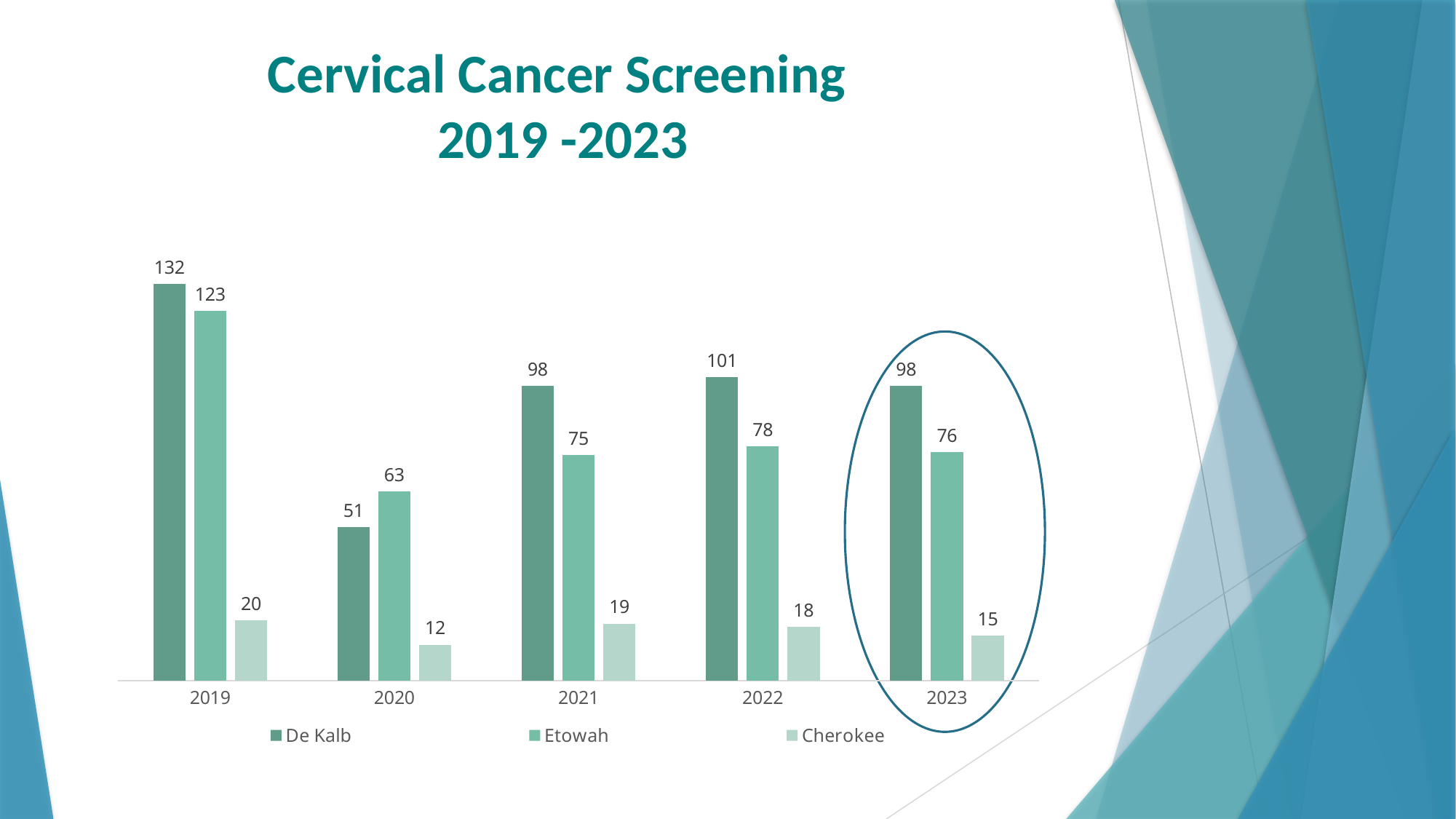
In which year is the De Kalb value lowest? 2020 How many years are shown on the x axis? 5 Which year's group of bars is circled on the chart? 2023 How many series does the legend list? 3 Which is larger in 2020, De Kalb or Etowah? Etowah What is the value for Etowah in 2020? 63 What is the difference between the De Kalb and Etowah values in 2022? 23 What kind of chart is shown on the slide? Bar chart What is the value for Cherokee in 2023? 15 What is the value for De Kalb in 2019? 132 What is the title of the chart? Cervical Cancer Screening 2019 -2023 In which year is the Etowah value highest? 2019